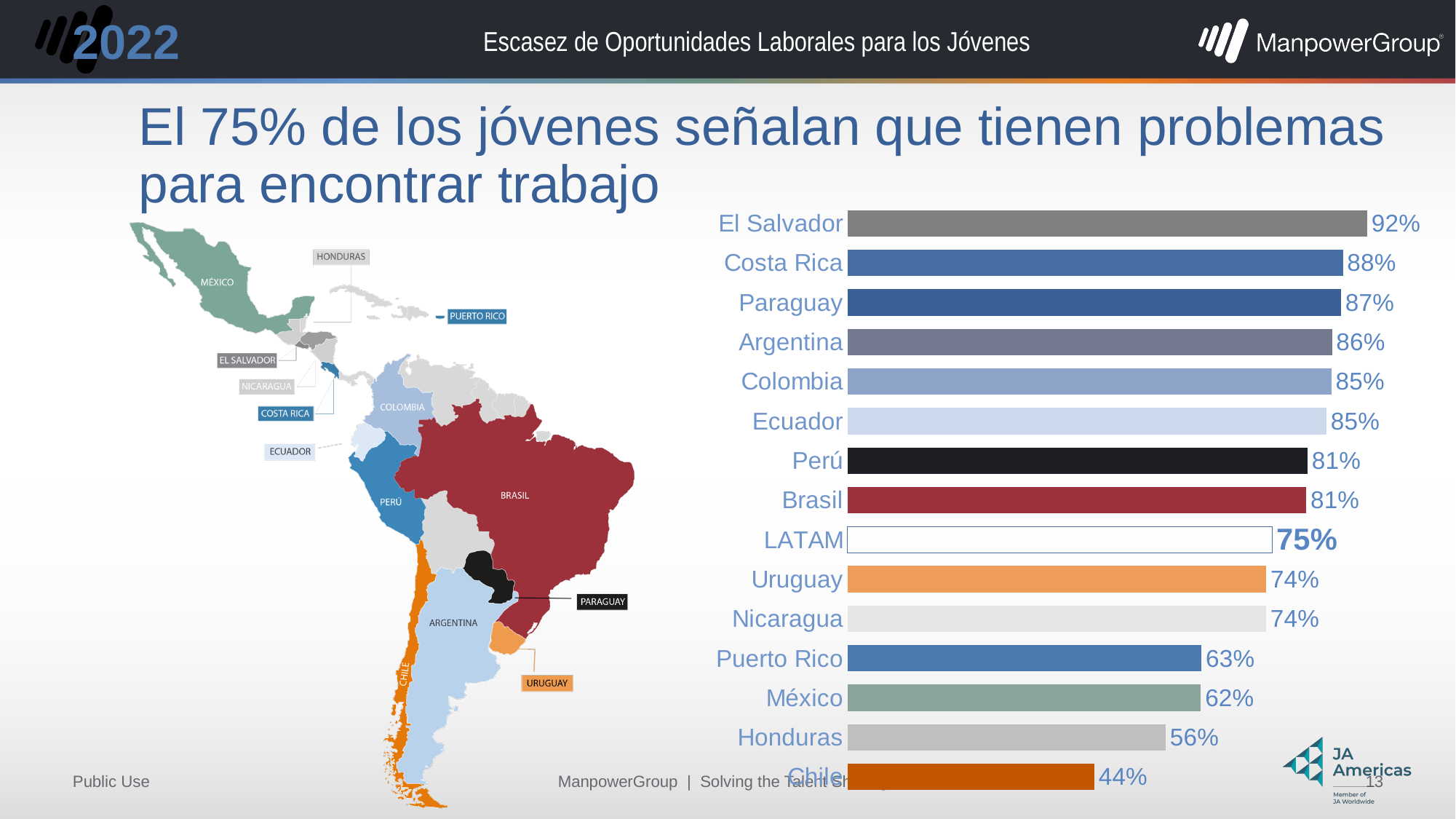
What is the difference between the values for El Salvador and Chile? 48% Which country has the lowest value? Chile What is the value for LATAM? 75% Which country has the highest value? El Salvador What kind of chart is shown on the slide? Bar chart What is the value for El Salvador? 92% What is the value for Nicaragua? 74% Which is larger, the value for Paraguay or the value for Brasil? Paraguay What is the value for Honduras? 56% How many bars are shown in the chart? 15 What is the difference between the values for Costa Rica and Puerto Rico? 25% Which is larger, the value for Uruguay or the value for México? Uruguay